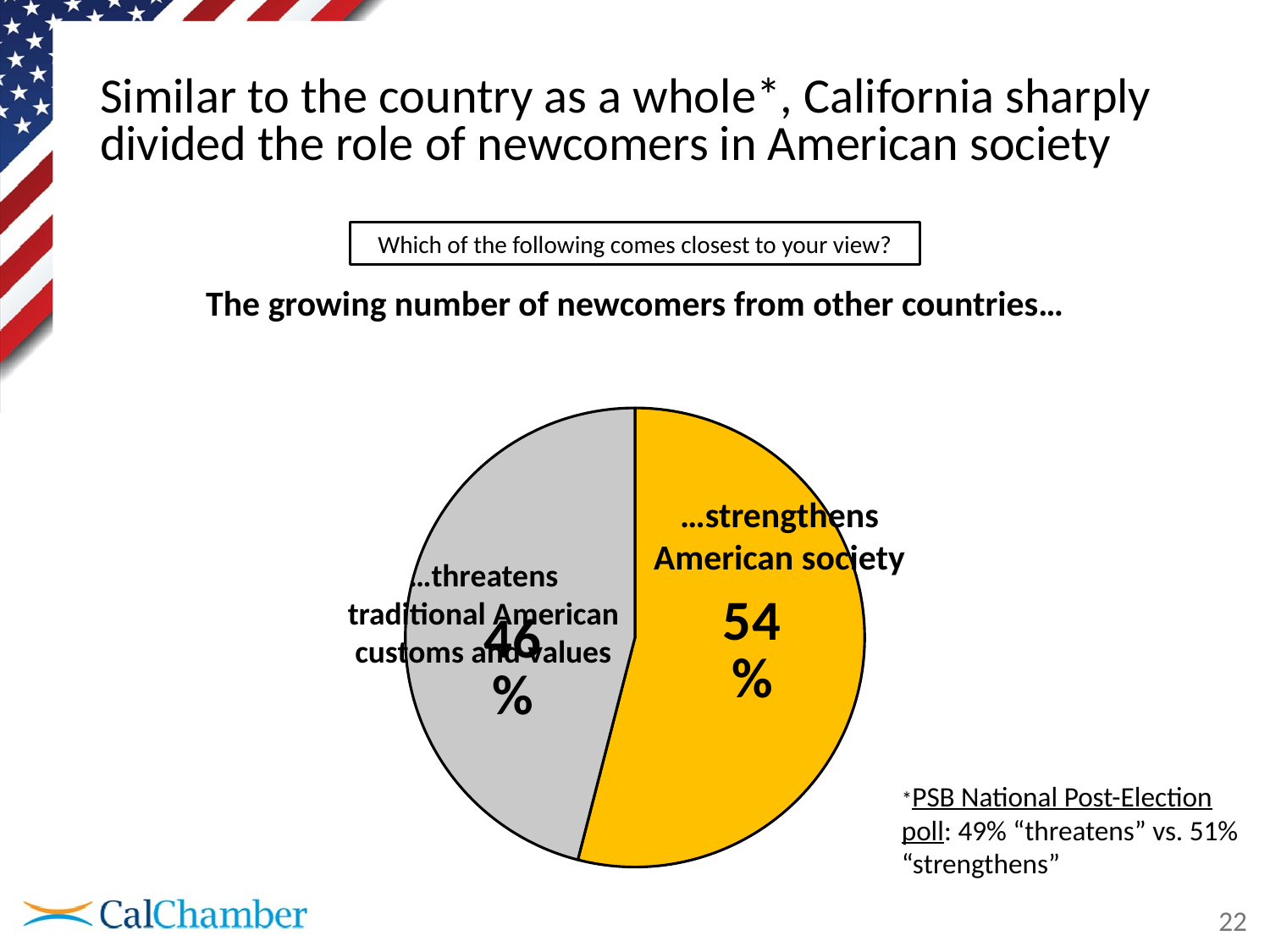
Is the value for 'threatens traditional American customs and values' greater or less than 50%? less What colour is the 'strengthens American society' slice? yellow Is the share for 'strengthens American society' larger or smaller than the share for 'threatens traditional American customs and values'? larger What do the two slices of the pie chart add up to? 100% What percentage of respondents said the growing number of newcomers threatens traditional American customs and values? 46% Which response has the larger share of the pie? …strengthens American society What is the difference in percentage points between the 'strengthens American society' and 'threatens traditional American customs and values' slices? 8 What kind of chart is shown on the slide? pie chart How many slices does the pie chart have? 2 What percentage of respondents said the growing number of newcomers strengthens American society? 54% Which response has the smaller share of the pie? …threatens traditional American customs and values What colour is the 'threatens traditional American customs and values' slice? gray